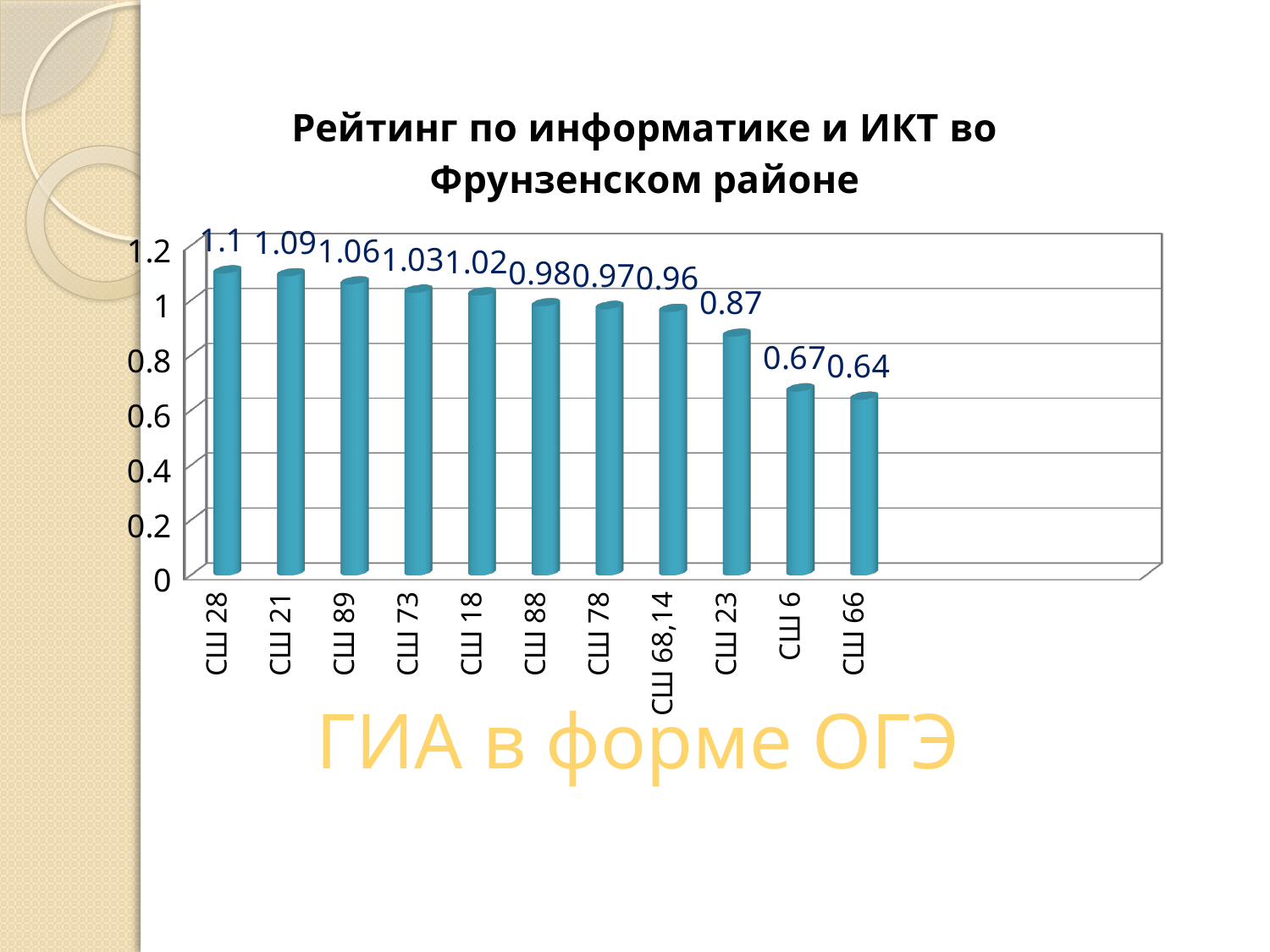
What kind of chart is shown on the slide? bar chart What is the value for СШ 23? 0.87 What is the title of the chart? Рейтинг по информатике и ИКТ во Фрунзенском районе Which is larger, the value for СШ 89 or the value for СШ 23? СШ 89 What is the value for СШ 66? 0.64 What is the value for СШ 88? 0.98 Which category has the lowest value? СШ 66 What is the value for СШ 28? 1.1 How many categories are shown on the x axis? 11 Do the values rise or fall from left to right along the x axis? fall Which category has the highest value? СШ 28 What is the difference between the values for СШ 28 and СШ 66? 0.46